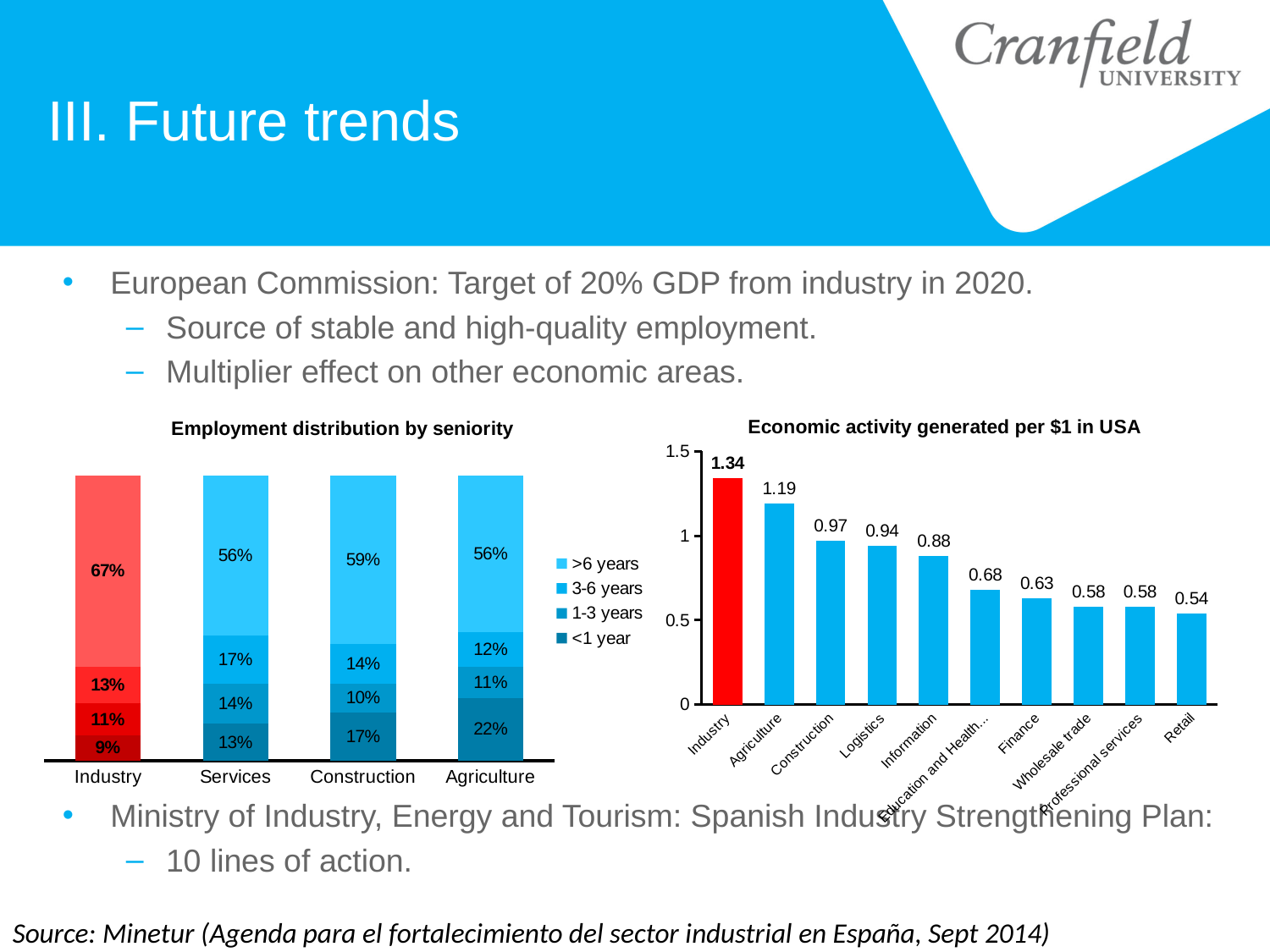
In the 'Economic activity generated per $1 in USA' chart, do the values rise or fall from left to right? fall In the 'Economic activity generated per $1 in USA' chart, which category has the highest value? Industry In the 'Economic activity generated per $1 in USA' chart, what is the value for Industry? 1.34 In the 'Employment distribution by seniority' chart, how many series does the legend list? 4 In the 'Employment distribution by seniority' chart, what is the '>6 years' share for Industry? 67% In the 'Employment distribution by seniority' chart, what is the '<1 year' share for Agriculture? 22% In the 'Economic activity generated per $1 in USA' chart, what is the value for Logistics? 0.94 In the 'Economic activity generated per $1 in USA' chart, how many categories are shown? 10 In the 'Economic activity generated per $1 in USA' chart, which category has the lowest value? Retail In the 'Employment distribution by seniority' chart, which is larger: the '>6 years' share for Construction or for Services? Construction What kind of chart is 'Employment distribution by seniority'? stacked bar chart In the 'Economic activity generated per $1 in USA' chart, what is the difference between the values for Industry and Agriculture? 0.15